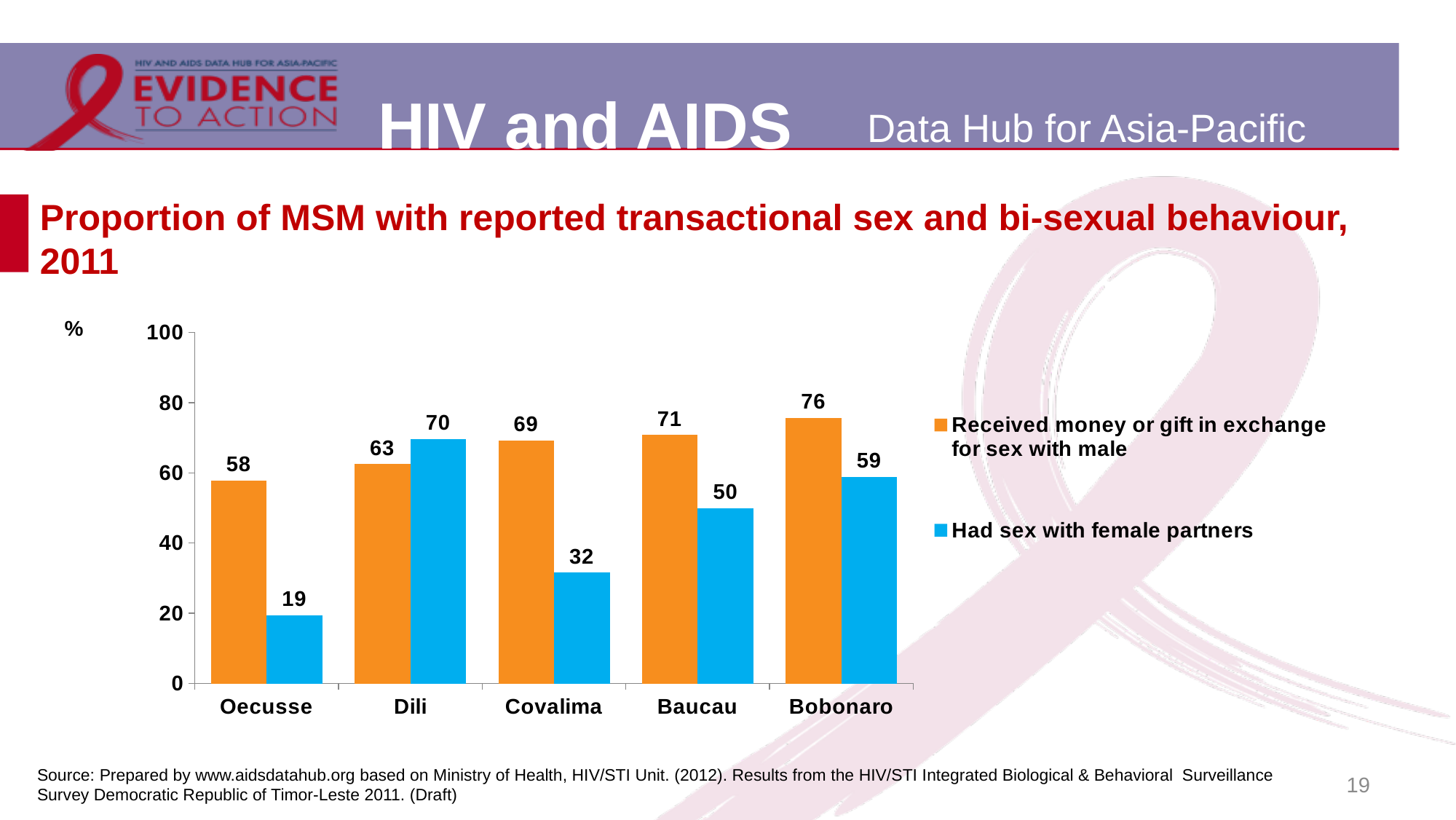
Which district has the highest value for 'Received money or gift in exchange for sex with male'? Bobonaro What is the value for 'Had sex with female partners' in Covalima? 32 How many series does the legend list? 2 Which district has the lowest value for 'Had sex with female partners'? Oecusse What kind of chart is shown on the slide? Bar chart What is the value for 'Had sex with female partners' in Bobonaro? 59 What is the value for 'Received money or gift in exchange for sex with male' in Oecusse? 58 What colour represents 'Had sex with female partners' in the chart? Blue How many districts are shown on the x axis? 5 What is the difference between the 'Received money or gift in exchange for sex with male' values for Bobonaro and Dili? 13 What is the difference between the two series values in Oecusse? 39 In Dili, which series has the larger value: 'Received money or gift in exchange for sex with male' or 'Had sex with female partners'? Had sex with female partners